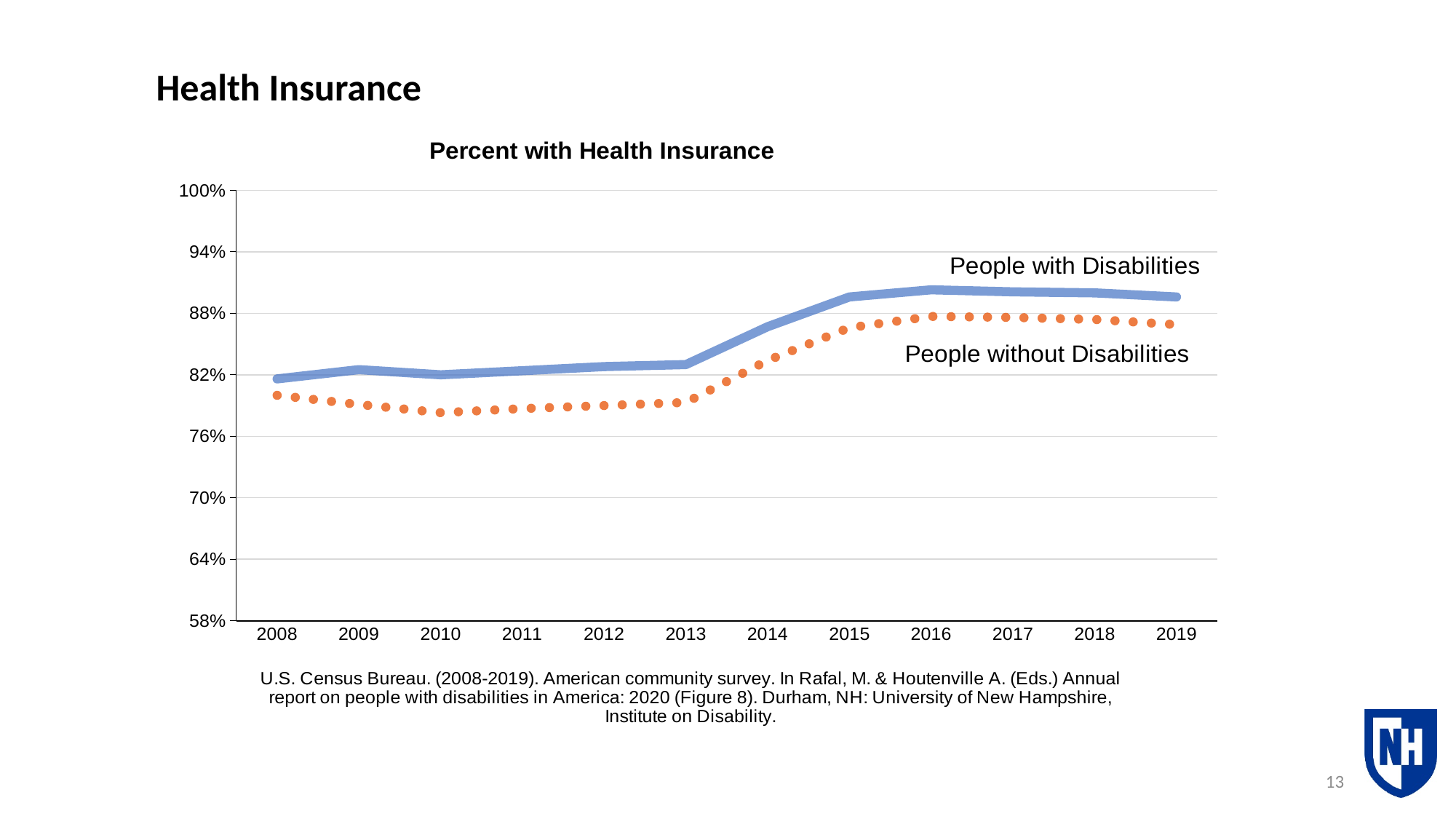
Is the value for People without Disabilities in 2010 greater or less than 82%? less What is the title of the chart? Percent with Health Insurance Which series is drawn as a dotted orange line? People without Disabilities Overall, do the values for People without Disabilities rise or fall from 2008 to 2019? rise How many years are shown along the x axis of the chart? 12 Is the value for People without Disabilities in 2017 greater or less than 82%? greater Is the value for People with Disabilities in 2012 greater or less than 88%? less How many data series are plotted in the chart? 2 In 2015, which series has the higher value: People with Disabilities or People without Disabilities? People with Disabilities What kind of chart is shown on the slide? Line chart